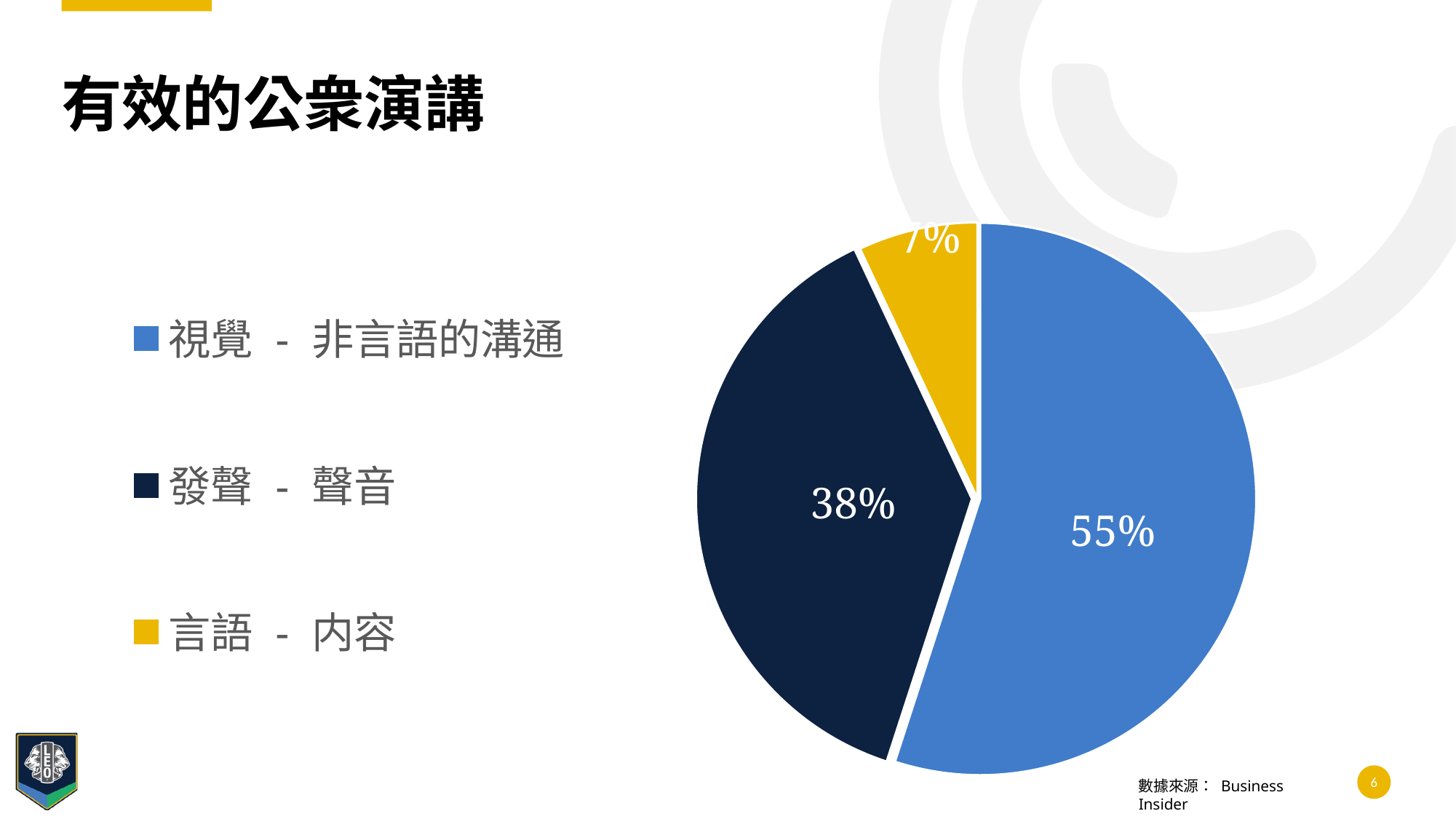
What colour is the slice for 言語 - 內容? yellow What is the title of the slide containing the pie chart? 有效的公眾演講 Which category has the largest slice of the pie? 視覺 - 非言語的溝通 What is the difference between the values for 發聲 - 聲音 and 言語 - 內容? 31% What is the difference between the values for 視覺 - 非言語的溝通 and 發聲 - 聲音? 17% Which category has the smallest slice of the pie? 言語 - 內容 What is the value shown for 發聲 - 聲音? 38% How many slices does the pie chart have? 3 What kind of chart is shown on the slide? pie chart Which is larger, the slice for 發聲 - 聲音 or the slice for 言語 - 內容? 發聲 - 聲音 What share of the pie does 視覺 - 非言語的溝通 take? 55% What is the value shown for 言語 - 內容? 7%